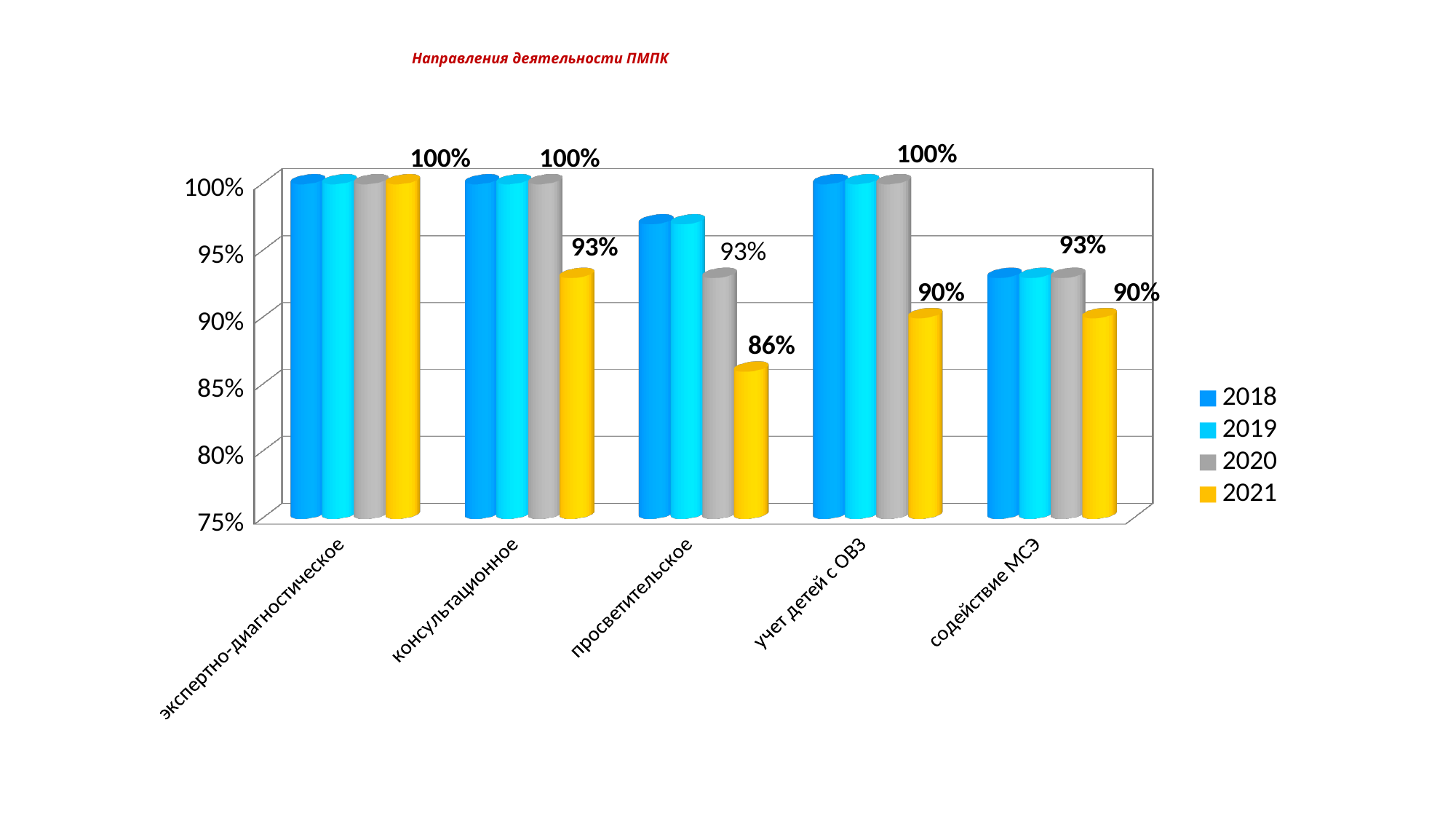
What is the 2021 value for просветительское? 86% What is the 2021 value for учет детей с ОВЗ? 90% What is the 2021 value for консультационное? 93% What kind of chart is shown on the slide? bar chart What is the difference between the 2020 and 2021 values for консультационное? 7% Which category has the lowest 2021 value? просветительское Is the 2018 value for просветительское greater or less than 95%? greater How many series does the legend list? 4 How many categories are shown on the x axis? 5 What is the 2020 value for содействие МСЭ? 93% Which is larger for 2021: консультационное or просветительское? консультационное What is the title of the chart? Направления деятельности ПМПК